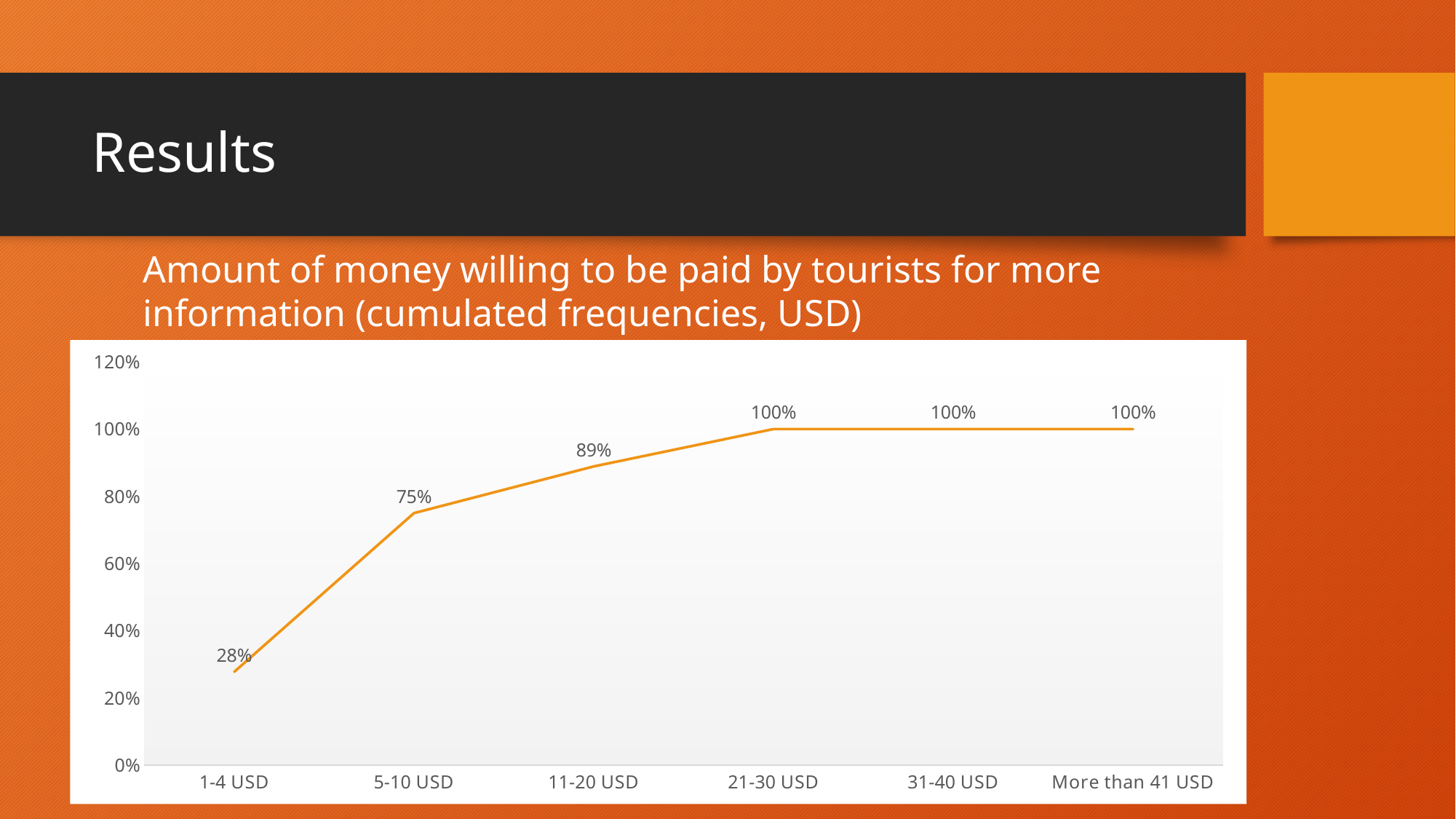
What is the cumulated frequency for the 5-10 USD category? 75% What kind of chart is shown on the slide? line chart What is the cumulated frequency for the 21-30 USD category? 100% How many categories are shown on the x axis? 6 What is the title of the chart? Amount of money willing to be paid by tourists for more information (cumulated frequencies, USD) What is the cumulated frequency for the 1-4 USD category? 28% Which category has the lowest cumulated frequency? 1-4 USD What is the cumulated frequency for the 11-20 USD category? 89% What is the difference between the cumulated frequencies for 5-10 USD and 1-4 USD? 47% What is the difference between the cumulated frequencies for 11-20 USD and 5-10 USD? 14% Do the values rise or fall from 1-4 USD to 21-30 USD? rise Which is larger, the value for 11-20 USD or the value for 5-10 USD? 11-20 USD